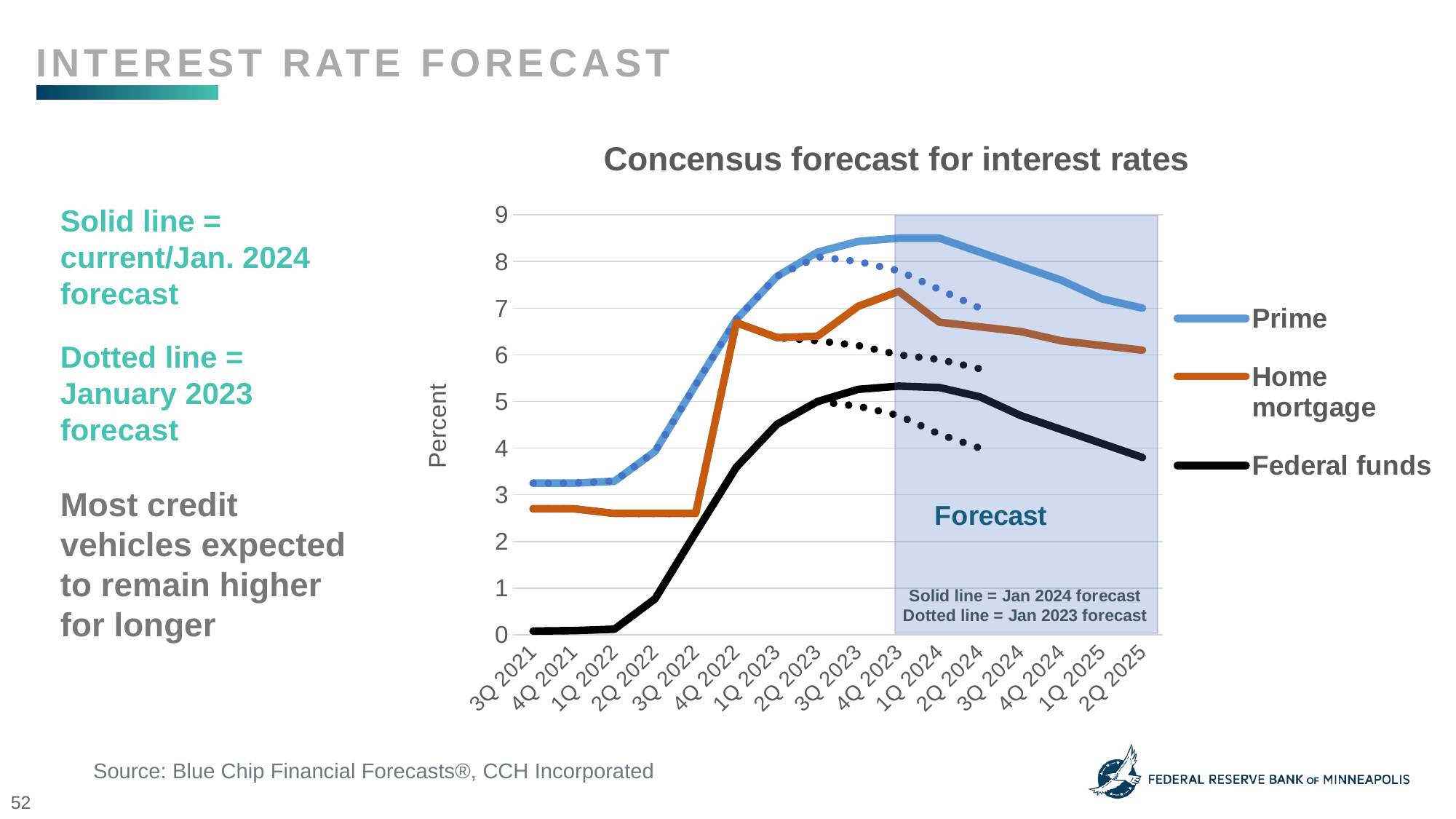
Is the solid-line value for Federal funds in 2Q 2025 greater or less than 5? less How many quarters are shown along the x axis? 16 Does the Federal funds line rise or fall from 3Q 2021 to 4Q 2023? rise Is the value for Home mortgage in 3Q 2021 greater or less than 3? less Which series has the lowest values across the chart? Federal funds What kind of chart is shown on the slide? line chart How many series does the legend list? 3 What is the title of the chart? Concensus forecast for interest rates Which is larger in 2Q 2025, the solid-line value for Prime or for Home mortgage? Prime Is the solid-line value for Prime in 1Q 2024 greater or less than 8? greater Which series has the highest values across the chart? Prime